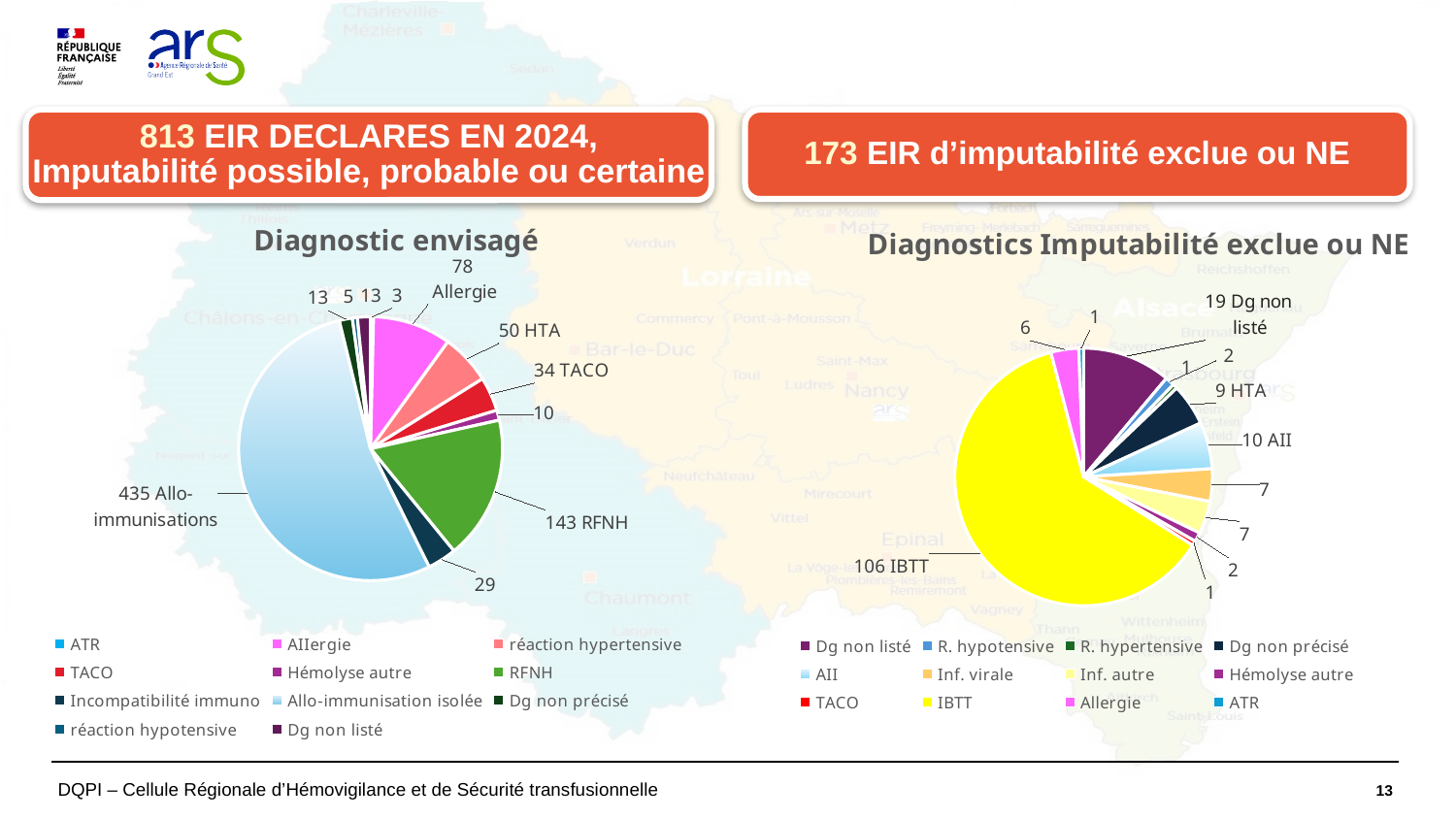
In the 'Diagnostics Imputabilité exclue ou NE' pie chart, what is the value for IBTT? 106 How many entries does the legend of the 'Diagnostics Imputabilité exclue ou NE' chart list? 12 In the 'Diagnostic envisagé' pie chart, what is the value for RFNH? 143 In the 'Diagnostics Imputabilité exclue ou NE' pie chart, what is the value for Dg non listé? 19 In the 'Diagnostics Imputabilité exclue ou NE' pie chart, which category has the largest slice? IBTT What kind of chart is the 'Diagnostic envisagé' chart? Pie chart In the 'Diagnostic envisagé' pie chart, which is larger, HTA or TACO? HTA In the 'Diagnostic envisagé' pie chart, what is the value for Allergie? 78 In the 'Diagnostic envisagé' pie chart, which category has the largest slice? Allo-immunisations In the 'Diagnostic envisagé' pie chart, what is the value for Allo-immunisations? 435 In the 'Diagnostics Imputabilité exclue ou NE' pie chart, what is the value for AII? 10 In the 'Diagnostic envisagé' pie chart, what is the difference between the RFNH value and the Allergie value? 65